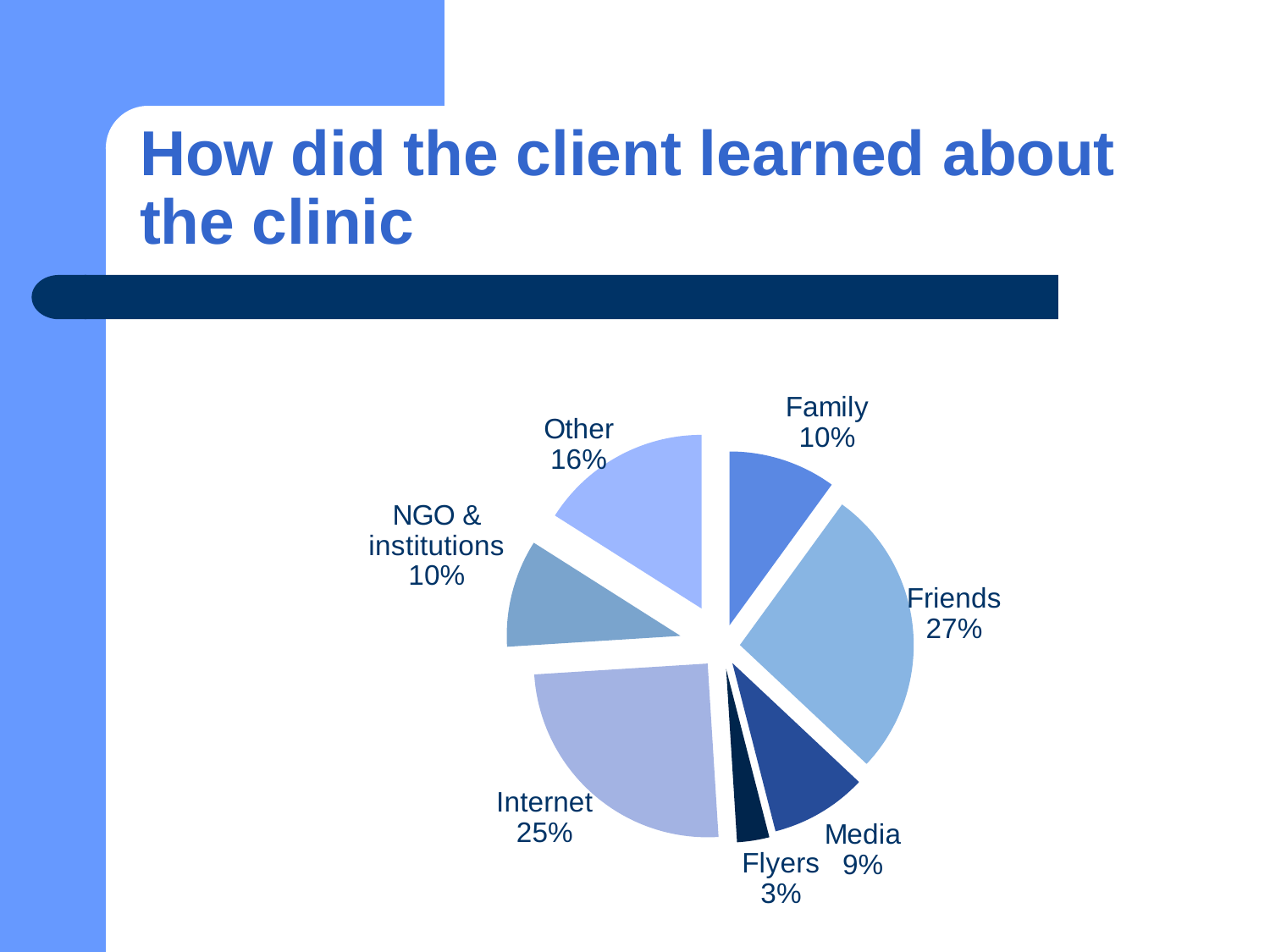
What share of clients learned about the clinic from Friends? 27% What share of clients learned about the clinic from Media? 9% What is the difference in percentage points between the Friends and Internet slices? 2 What share of clients learned about the clinic from the Internet? 25% How many slices does the pie chart have? 7 What kind of chart is shown on the slide? pie chart What share of clients learned about the clinic from Flyers? 3% What share of clients learned about the clinic from NGO & institutions? 10% Which slice is larger, Other or Family? Other What is the title of the slide containing the pie chart? How did the client learned about the clinic Which source has the smallest share of the pie? Flyers Which source has the largest share of the pie? Friends